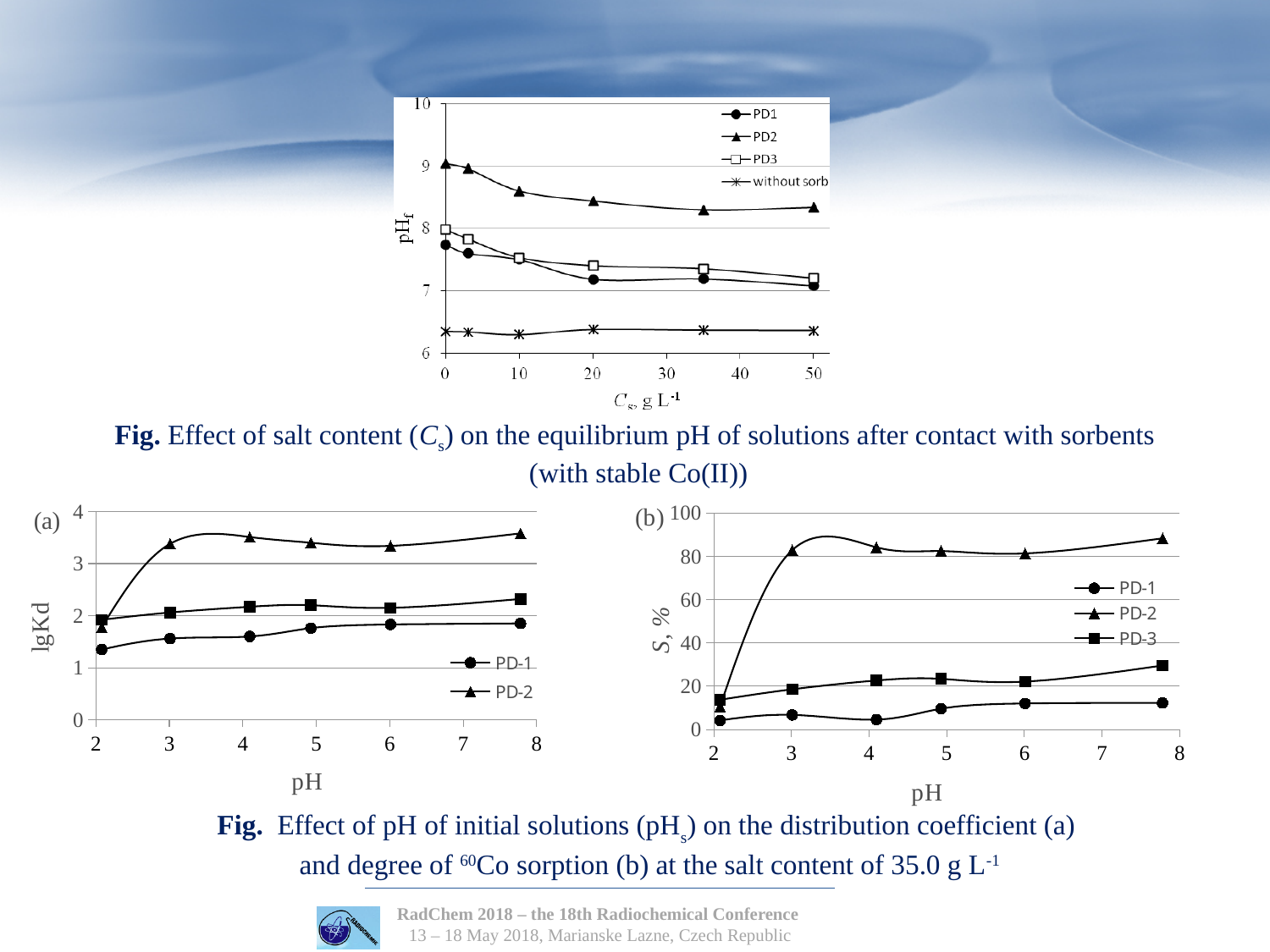
In chart (a) (lgKd versus pH), is the lgKd for PD-2 at pH 6 greater or less than 3? greater In chart (b) (S, % versus pH), at pH 5, which series has the larger value, PD-3 or PD-1? PD-3 In chart (b) (S, % versus pH), which series has the highest sorption degree? PD-2 In chart (b) (S, % versus pH), is the value for PD-1 at pH 2 greater or less than 20? less In the top chart (pH_f versus C_s), is the pH_f for 'without sorb' at C_s = 20 greater or less than 7? less In the top chart (pH_f versus C_s), how many series does the legend list? 4 In the top chart (pH_f versus C_s), which series has the highest pH_f values? PD2 In chart (a) (lgKd versus pH), how many series does the legend list? 2 In the top chart (pH_f versus C_s), does the pH_f for PD2 rise or fall as C_s increases? fall In the top chart (pH_f versus C_s), which series has the lowest pH_f values? without sorb In the top chart (pH_f versus C_s), how many data points are plotted for the PD2 series? 6